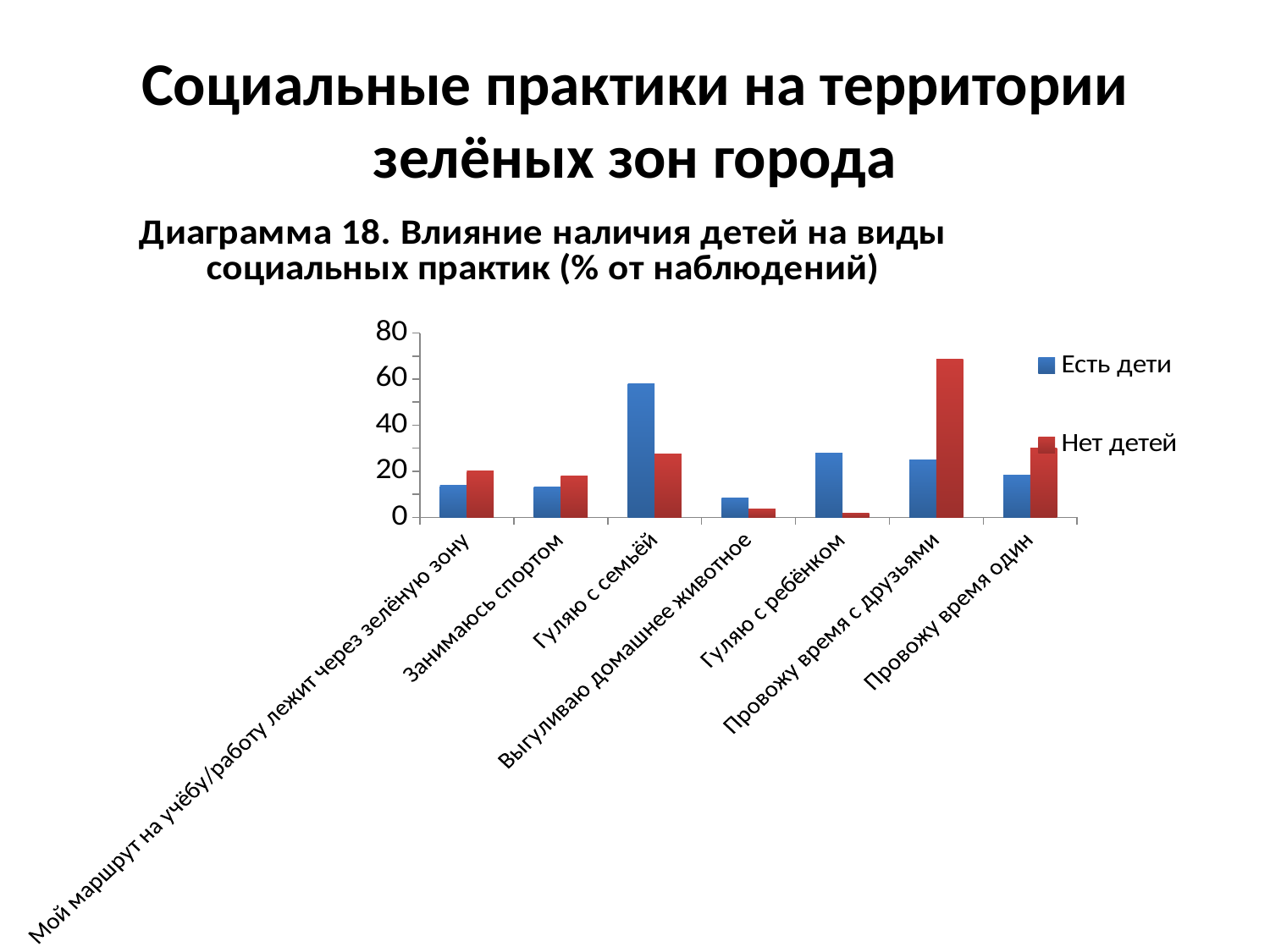
How many categories are shown on the x axis of the chart? 7 Which category has the lowest value for the series "Нет детей"? Гуляю с ребёнком How many series does the legend list? 2 Which category has the highest value for the series "Есть дети"? Гуляю с семьёй What kind of chart is shown on the slide? bar chart For the category "Провожу время с друзьями", which series has the larger value, "Есть дети" or "Нет детей"? Нет детей Which category has the lowest value for the series "Есть дети"? Выгуливаю домашнее животное For the category "Гуляю с семьёй", which series has the larger value, "Есть дети" or "Нет детей"? Есть дети Is the value for "Есть дети" in the category "Гуляю с ребёнком" greater or less than 40? less Is the value for "Нет детей" in the category "Провожу время с друзьями" greater or less than 60? greater Which category has the highest value for the series "Нет детей"? Провожу время с друзьями What are the two series names listed in the legend? Есть дети, Нет детей